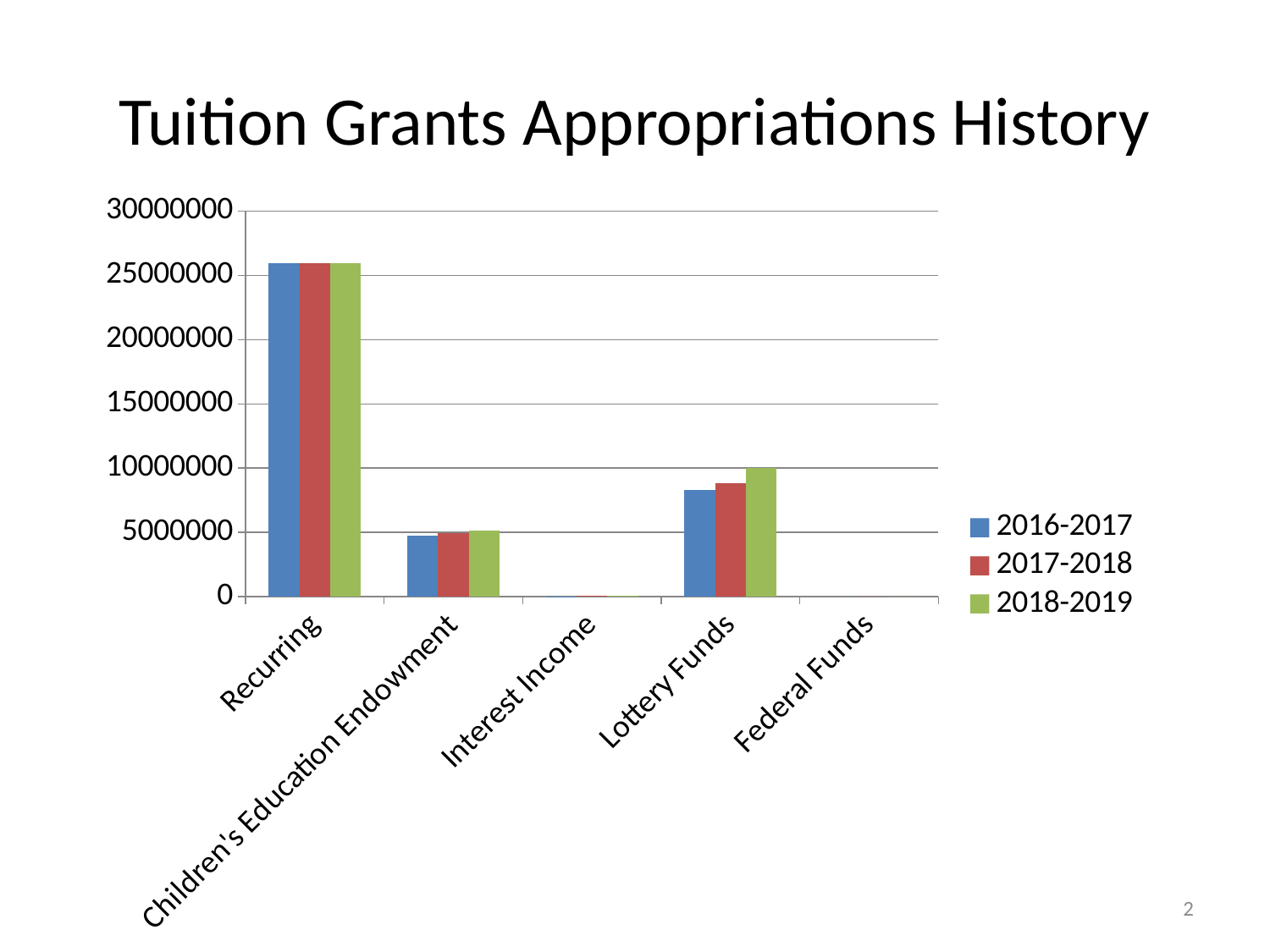
What is the title of the chart? Tuition Grants Appropriations History What kind of chart is shown on the slide? bar chart Is the value for Recurring in 2018-2019 greater or less than 20000000? greater Which series is shown in green in the legend? 2018-2019 How many categories are shown on the x axis? 5 Do the Lottery Funds values rise or fall from 2016-2017 to 2018-2019? rise How many series does the legend list? 3 For the 2018-2019 series, which is larger: Lottery Funds or Children's Education Endowment? Lottery Funds Is the value for Recurring in 2016-2017 greater or less than 25000000? greater Is the value for Lottery Funds in 2016-2017 greater or less than 10000000? less Which category has the highest value for the 2016-2017 series? Recurring